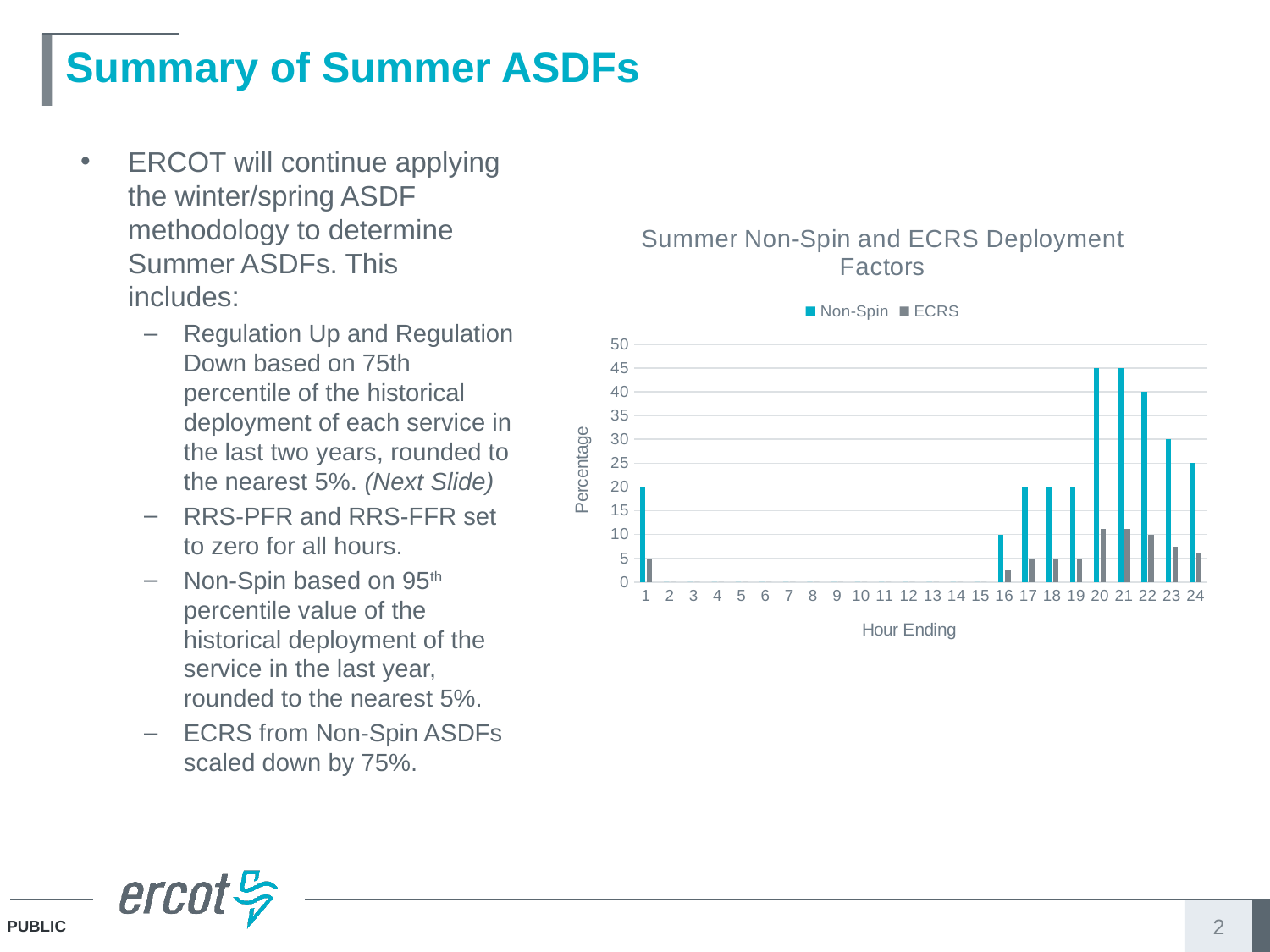
What is the Non-Spin value for Hour Ending 23? 30 How many series does the chart legend list? 2 How many Hour Ending categories are shown on the x axis? 24 What is the difference between the Non-Spin values for Hour Ending 20 and Hour Ending 23? 15 Which has the larger Non-Spin value, Hour Ending 22 or Hour Ending 23? Hour Ending 22 What is the highest Non-Spin value shown on the chart? 45 What type of chart is shown on the slide? bar chart What is the Non-Spin value for Hour Ending 20? 45 Is the ECRS value for Hour Ending 21 greater or less than 15? less Do the Non-Spin values rise or fall from Hour Ending 16 to Hour Ending 20? rise What is the title of the chart? Summer Non-Spin and ECRS Deployment Factors What is the Non-Spin value for Hour Ending 1? 20